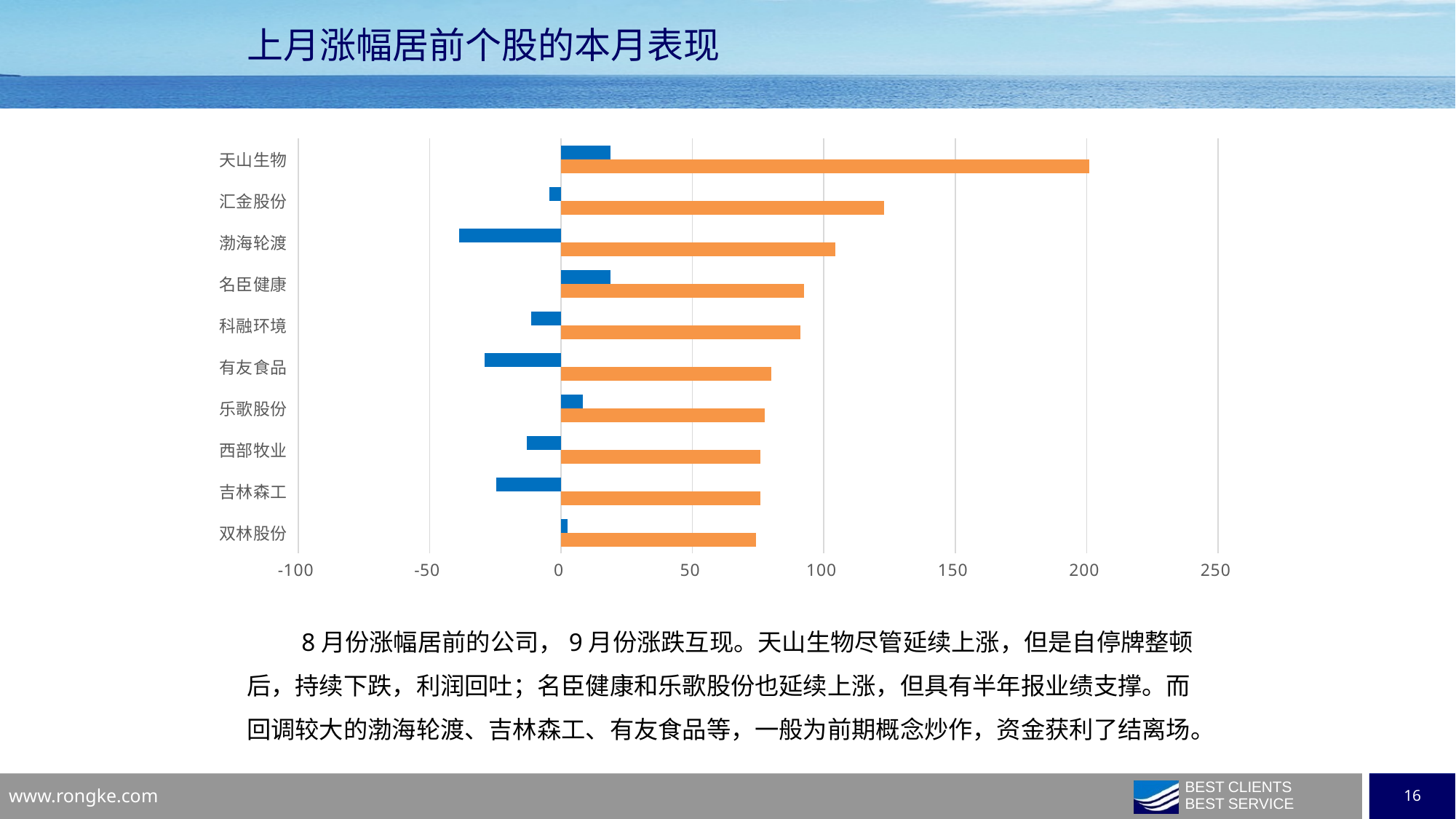
How many bars are plotted for each stock on the chart? 2 What kind of chart is shown on the slide? bar chart What is the title of the slide containing the chart? 上月涨幅居前个股的本月表现 How many stocks (categories) are listed on the chart? 10 Is the orange bar for 汇金股份 greater or less than 100? greater Which stock has the lowest (most negative) blue bar? 渤海轮渡 Is the orange bar for 天山生物 greater or less than 150? greater Which has the larger orange bar, 汇金股份 or 渤海轮渡? 汇金股份 Which stock has the longest orange bar? 天山生物 Is the blue bar for 吉林森工 greater or less than -50? greater Do the orange bars get longer or shorter going from the top stock to the bottom stock? shorter